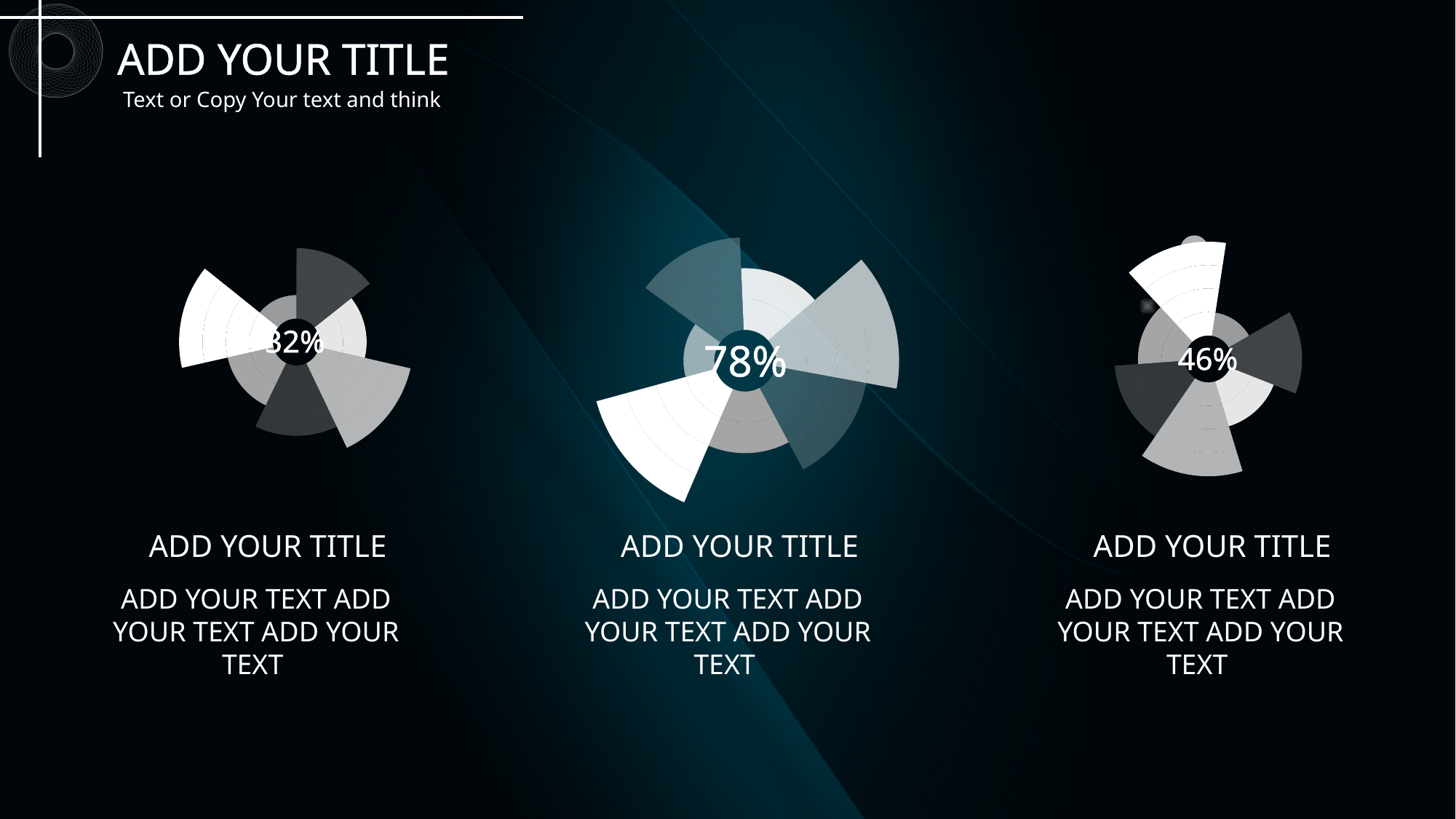
What percentage is printed at the centre of the right chart? 46% What is the main title text at the top of the slide? ADD YOUR TITLE Which of the three charts shows the highest centre percentage? The middle chart (78%) What is the difference between the centre percentages of the right chart and the left chart? 14 percentage points What percentage is printed at the centre of the left chart? 32% What is the difference between the centre percentages of the middle chart and the right chart? 32 percentage points Which has the larger centre percentage, the left chart or the right chart? The right chart What percentage is printed at the centre of the middle chart? 78% What kind of chart is used for each of the three graphics on the slide? Polar (rose) chart Which of the three charts shows the lowest centre percentage? The left chart (32%) How many charts are shown on the slide? 3 What is the difference between the centre percentages of the middle chart and the left chart? 46 percentage points